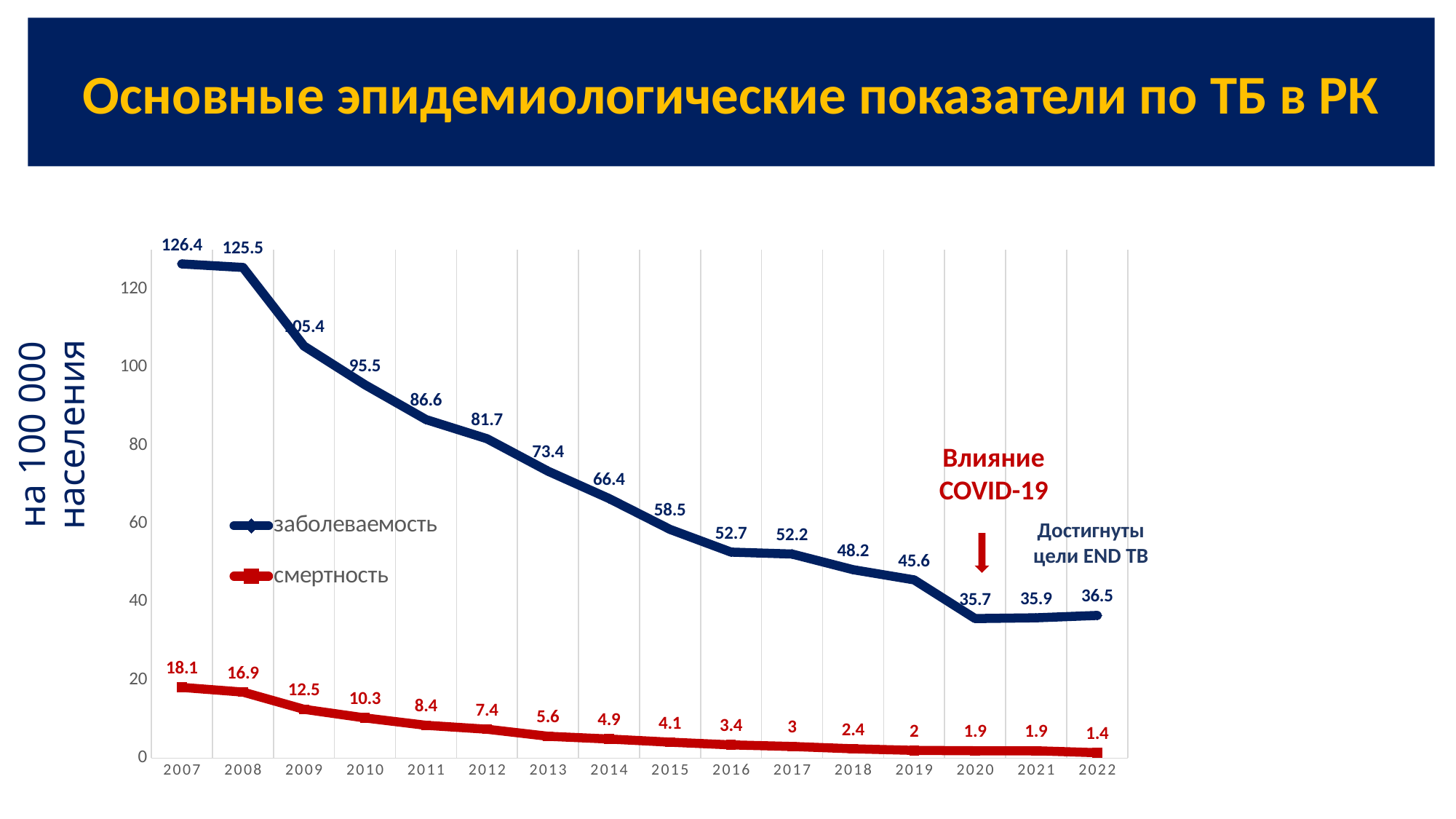
What is the value of заболеваемость in 2020? 35.7 Which is larger: смертность in 2009 or смертность in 2010? 2009 What is the value of смертность in 2022? 1.4 What is the value of смертность in 2013? 5.6 What is the difference between заболеваемость in 2007 and in 2022? 89.9 In which year is заболеваемость lowest? 2020 What is the value of заболеваемость in 2007? 126.4 Is the value of заболеваемость in 2015 greater or less than 60? less In which year is смертность highest? 2007 How many years are shown on the x axis? 16 What kind of chart is shown on the slide? line chart How many series does the legend list? 2